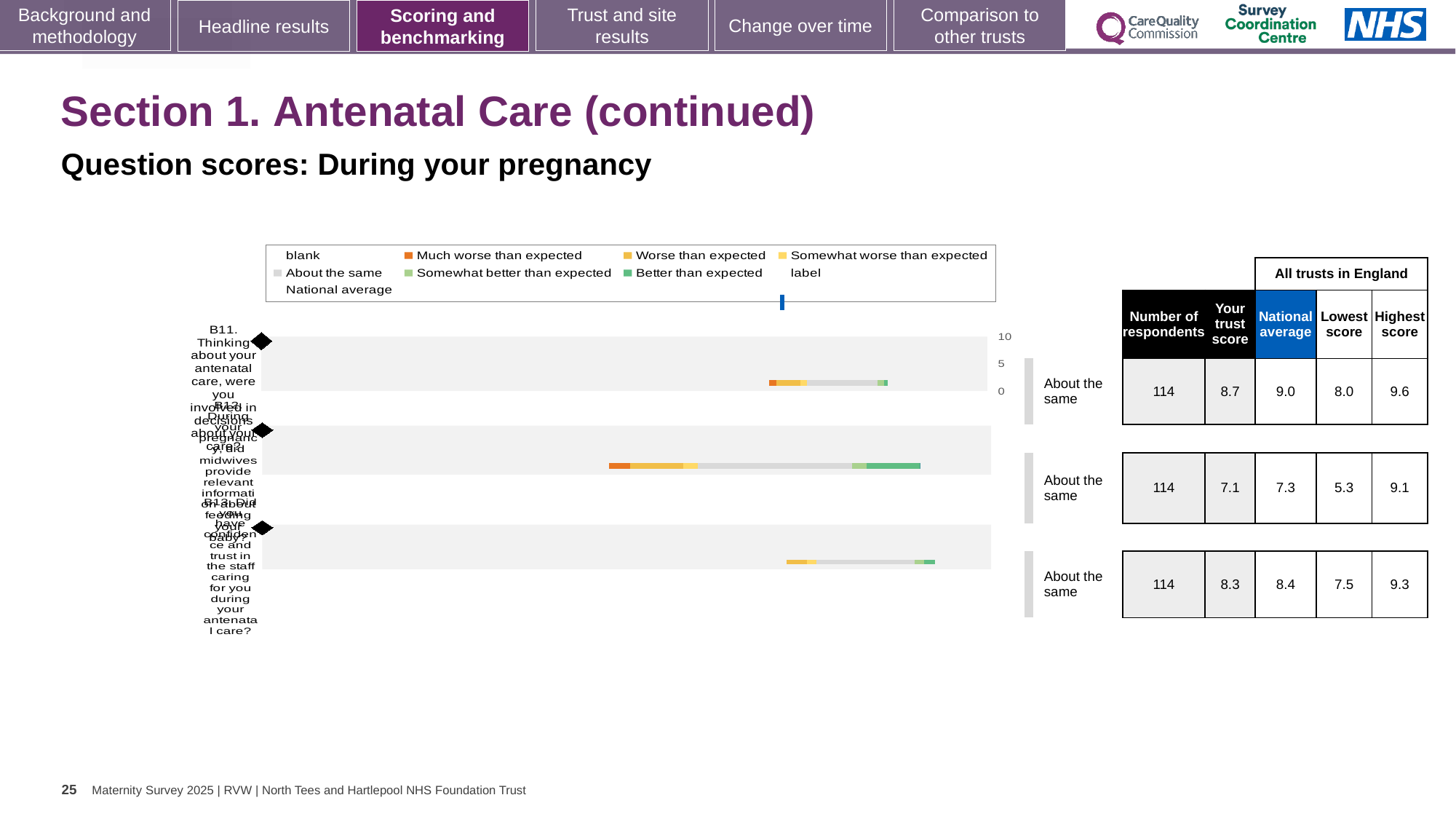
What kind of chart is shown on the slide? bar chart How many entries does the chart legend list? 9 What is the highest value shown on the chart's numeric axis? 10 How many question rows (categories) does the chart show? 3 What is the lowest score for question B13 in the table beside the chart? 7.5 How many respondents are listed for question B12? 114 What is the difference between the highest score and the lowest score for question B11? 1.6 What is the national average for question B12 in the table beside the chart? 7.3 Which legend entry is shown in orange? Much worse than expected What is the trust score for question B11 in the table beside the chart? 8.7 Which question has the lowest trust score in the table: B11, B12 or B13? B12 Which is larger, the trust score for B11 or the trust score for B13? B11